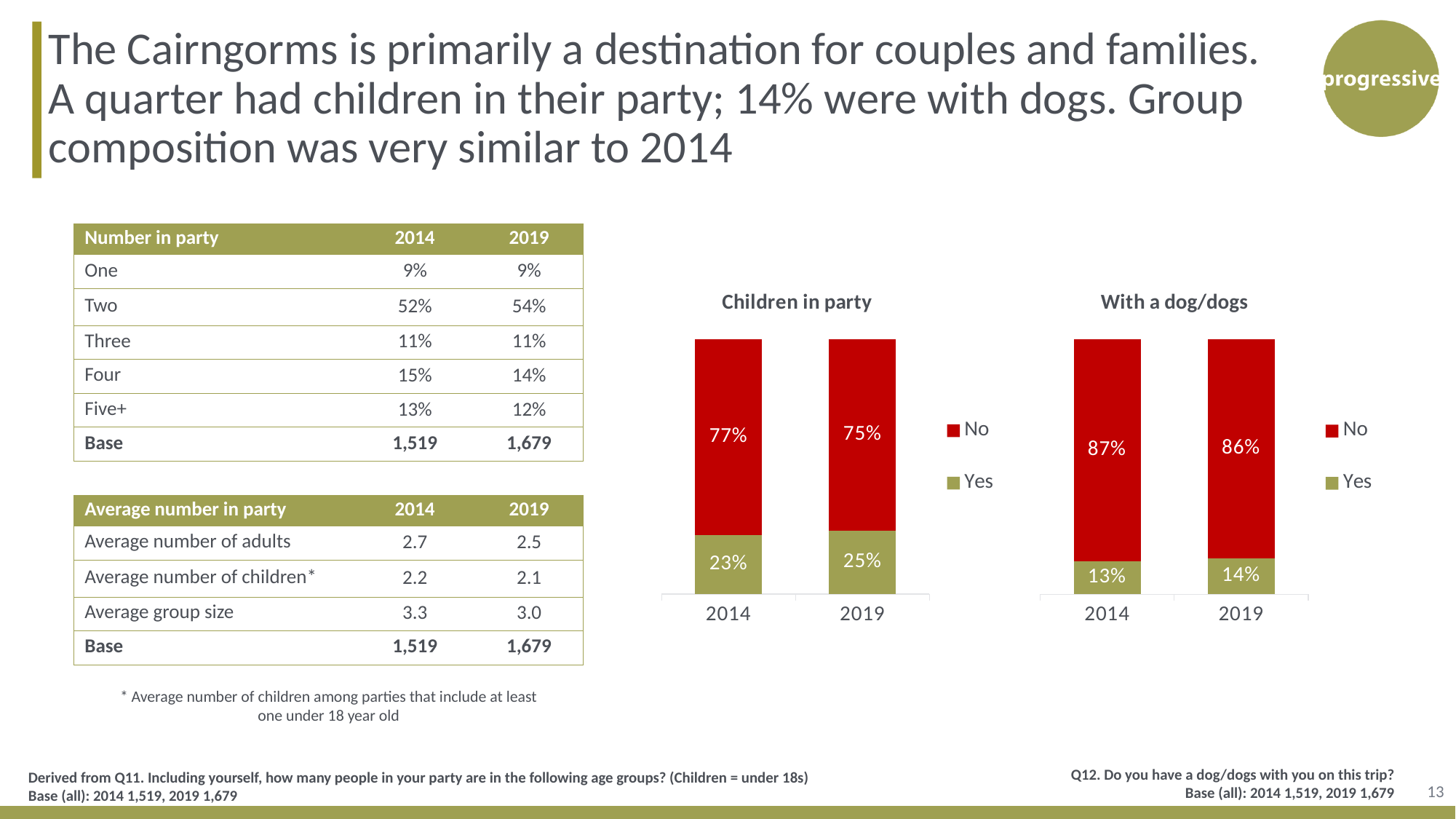
In the 'With a dog/dogs' chart, which year has the larger 'Yes' value? 2019 How many series does the legend of the 'Children in party' chart list? 2 What kind of chart is the 'Children in party' chart? Stacked bar chart In the 'With a dog/dogs' chart, what is the 'No' value for 2019? 86% In the 'Children in party' chart, what is the 'Yes' value for 2019? 25% In the 'Children in party' chart, what is the 'No' value for 2014? 77% In the 'With a dog/dogs' chart, what colour represents the 'No' series? Red In the 'Children in party' chart, what is the difference between the 'No' values for 2014 and 2019? 2 percentage points In the 'With a dog/dogs' chart, what is the total of the stacked bar for 2014? 100% In the 'Children in party' chart, which year has the higher 'Yes' value? 2019 How many categories are shown on the x axis of the 'With a dog/dogs' chart? 2 In the 'With a dog/dogs' chart, what is the 'Yes' value for 2014? 13%